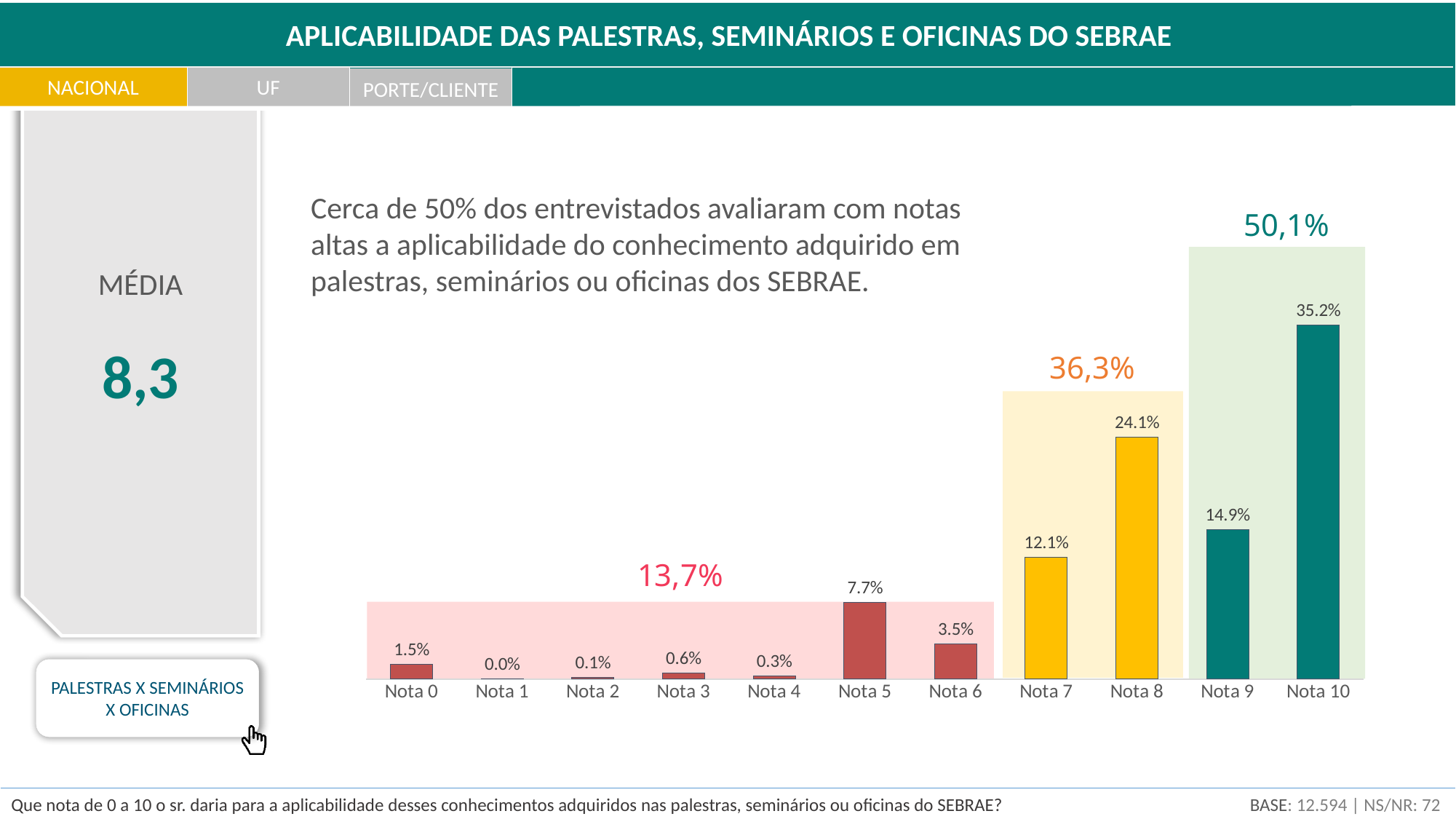
Which is larger, the value for Nota 7 or the value for Nota 9? Nota 9 What is the combined share shown for the group Nota 7 and Nota 8? 36,3% Which category has the lowest value? Nota 1 What is the value for Nota 5? 7.7% How many categories are shown on the x axis? 11 What is the value for Nota 10? 35.2% What is the combined share shown for the group Nota 9 and Nota 10? 50,1% What kind of chart is shown? bar chart What is the difference between the values for Nota 10 and Nota 9? 20.3% Which category has the highest value? Nota 10 What is the value of the MÉDIA shown on the left of the slide? 8,3 What is the value for Nota 8? 24.1%